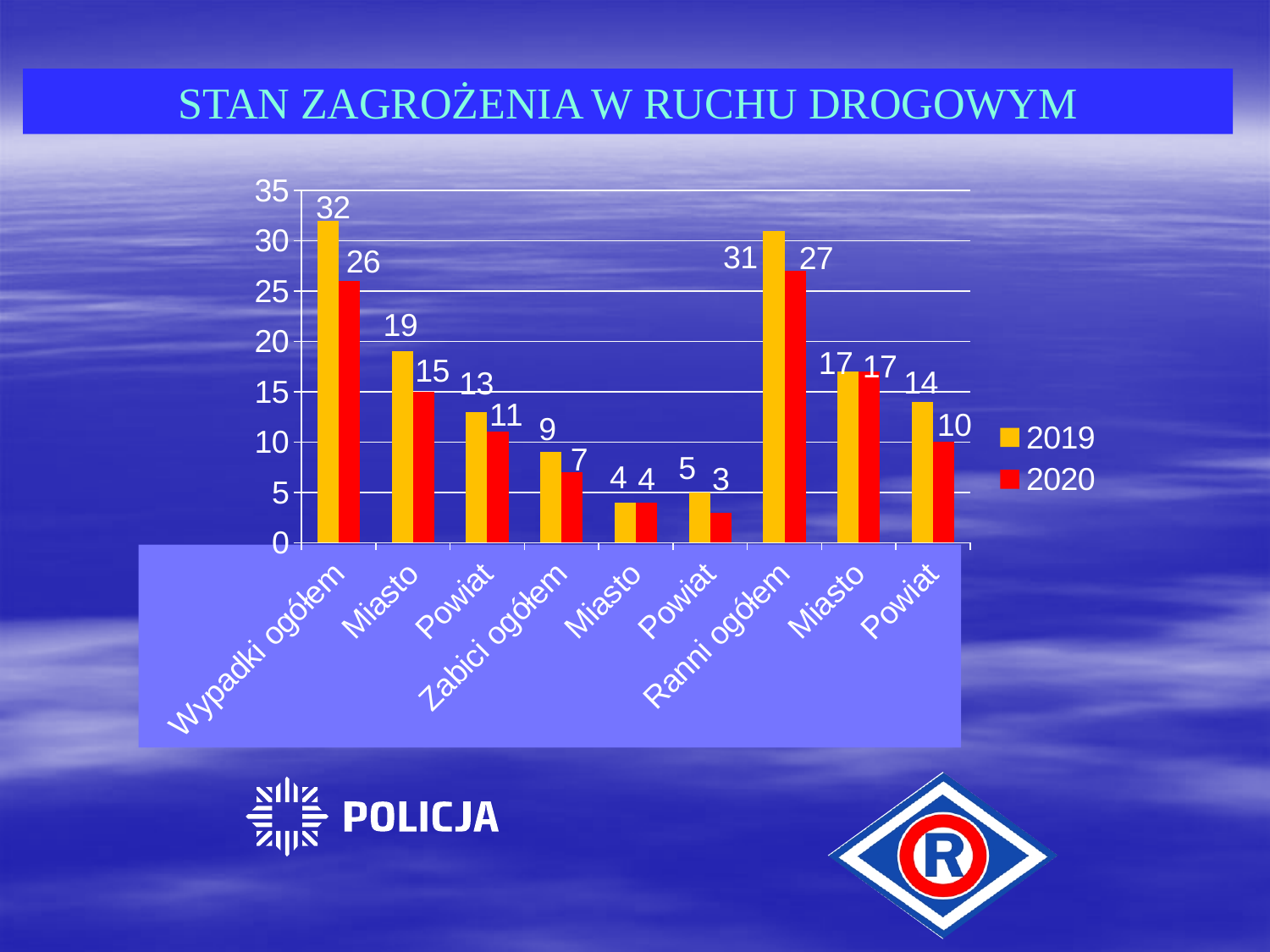
What is the 2020 value for Ranni ogółem? 27 How many categories are shown on the x axis? 9 What is the title of the slide above the chart? STAN ZAGROŻENIA W RUCHU DROGOWYM Which category has the lowest 2020 value? Powiat (the one following Zabici ogółem) What is the difference between the 2019 and 2020 values for Wypadki ogółem? 6 What kind of chart is shown on the slide? bar chart Which category has the highest 2019 value? Wypadki ogółem How many series does the legend list? 2 Which is larger for Zabici ogółem: the 2019 value or the 2020 value? 2019 What is the 2020 value for Zabici ogółem? 7 What is the difference between the 2019 and 2020 values for Ranni ogółem? 4 What is the 2019 value for Wypadki ogółem? 32